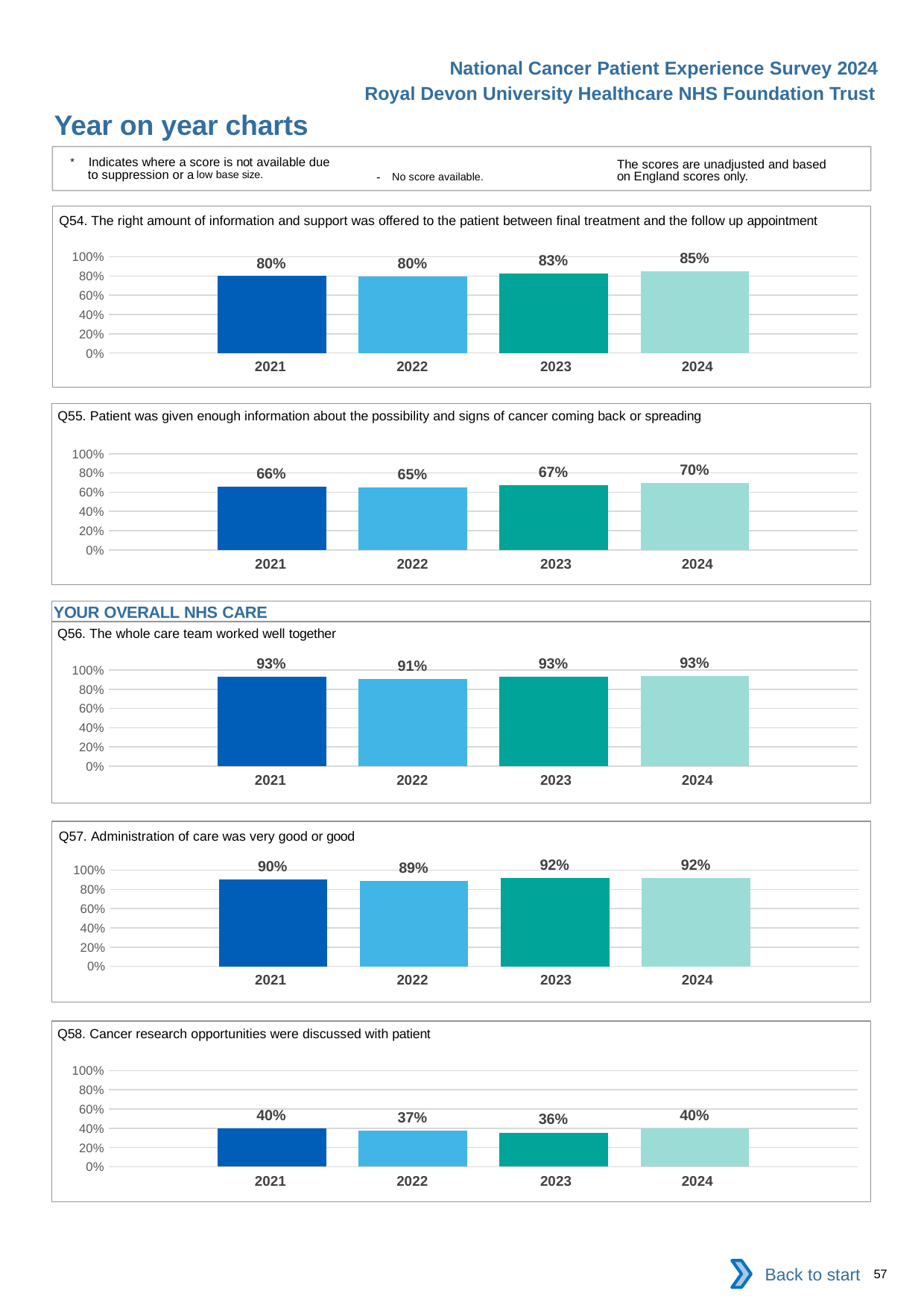
In the Q57 chart, what is the difference between the 2023 and 2022 values? 3% In the Q54 chart, what is the value for 2024? 85% In the Q57 chart, which is larger, the value for 2021 or the value for 2022? 2021 In the Q56 chart, what is the value for 2022? 91% In the Q54 chart, do the values rise or fall from 2021 to 2024? rise In the Q55 chart, what is the difference between the 2024 and 2021 values? 4% What kind of chart is the Q57 chart? bar chart How many charts are shown on the slide? 5 In the Q54 chart, how many years are plotted? 4 In the Q55 chart, which year has the lowest value? 2022 In the Q58 chart, which year has the lowest value? 2023 In the Q58 chart, what is the value for 2022? 37%